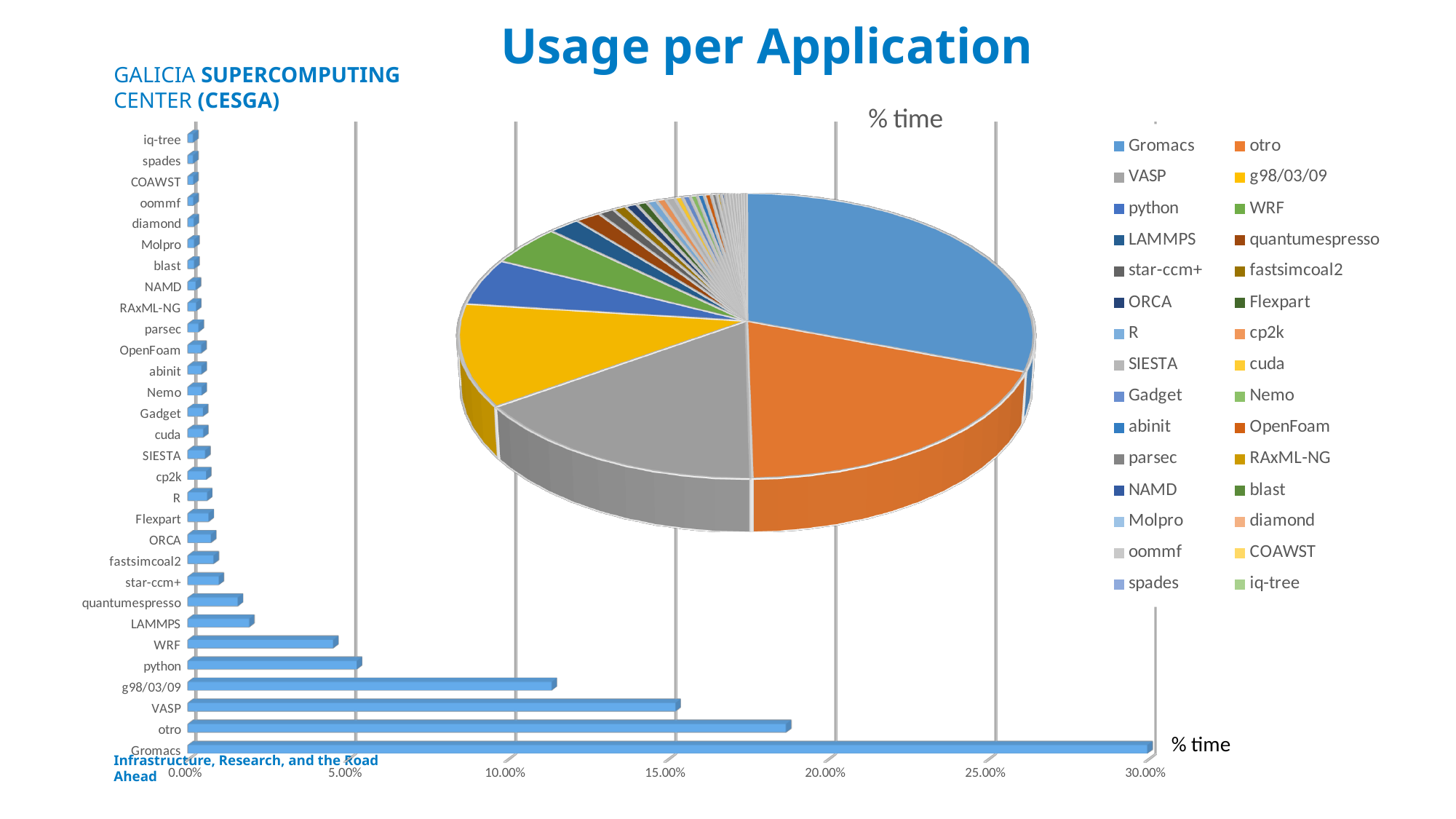
In the bar chart, is the value for otro greater or less than 15.00%? greater In the bar chart, is the value for g98/03/09 greater or less than 10.00%? greater In the pie chart, which application has the largest slice? Gromacs In the bar chart, which has a larger % time, g98/03/09 or python? g98/03/09 In the bar chart, which application has the highest % time? Gromacs In the bar chart, is the value for otro greater or less than 20.00%? less In the bar chart, which has a larger % time, otro or VASP? otro What kind of chart is shown on the left side of the slide? bar chart In the bar chart, how many applications are listed on the vertical axis? 30 What kind of chart is shown on the right side of the slide, titled '% time'? pie chart How many entries does the legend of the pie chart list? 30